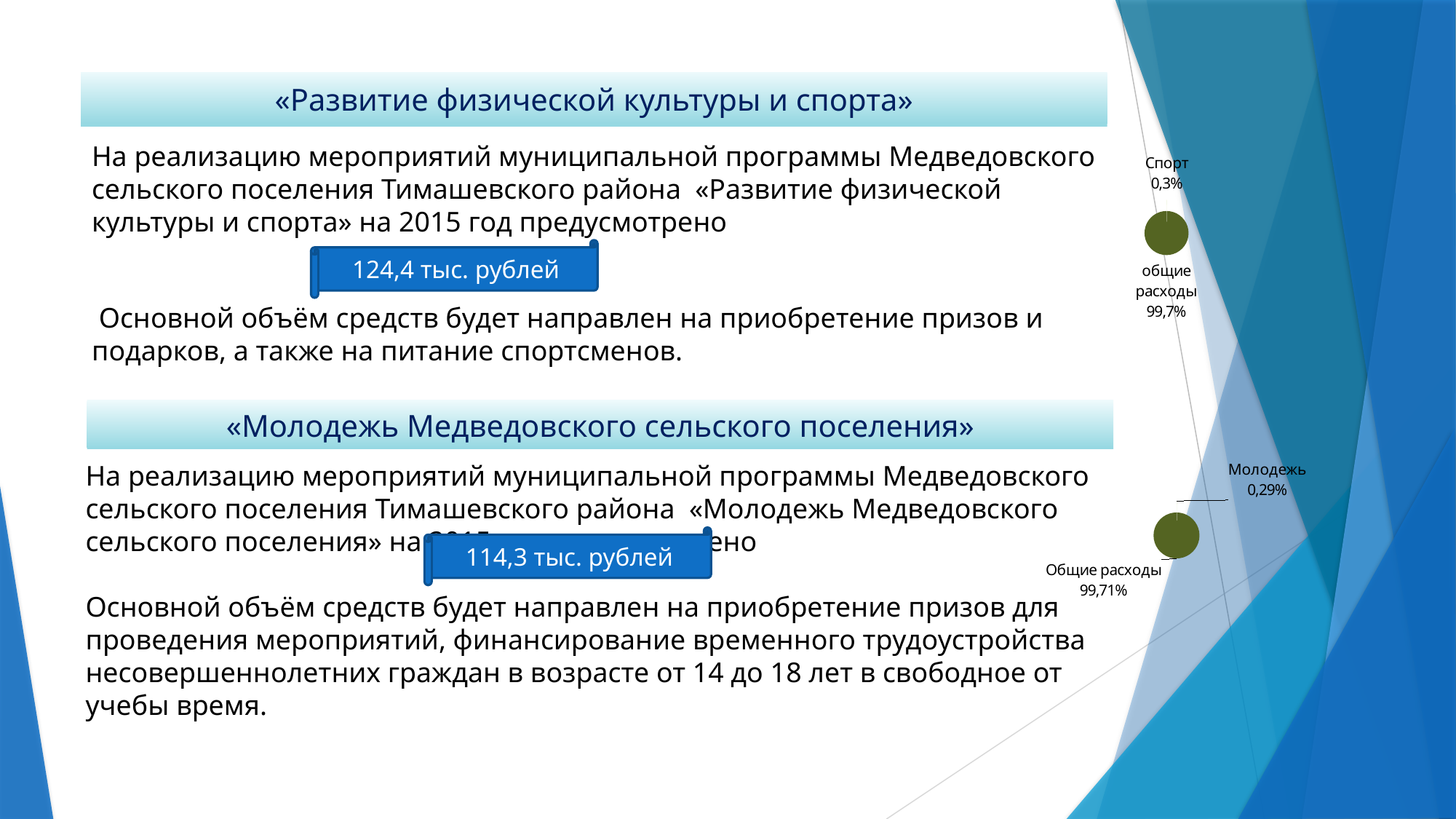
In the upper pie chart, what share is labelled for общие расходы? 99,7% What kind of chart is the lower chart on the right side of the slide? pie chart In the lower pie chart, what share is labelled for Молодежь? 0,29% How many slices does the lower pie chart have? 2 In the lower pie chart, which slice is the largest? Общие расходы How many slices does the upper pie chart have? 2 In the upper pie chart, what share is labelled for Спорт? 0,3% In the lower pie chart, what share is labelled for Общие расходы? 99,71% What kind of chart is the upper chart on the right side of the slide? pie chart In the upper pie chart, which slice is the smallest? Спорт In the upper pie chart, which slice is the largest? общие расходы In the lower pie chart, which is larger: Молодежь or Общие расходы? Общие расходы